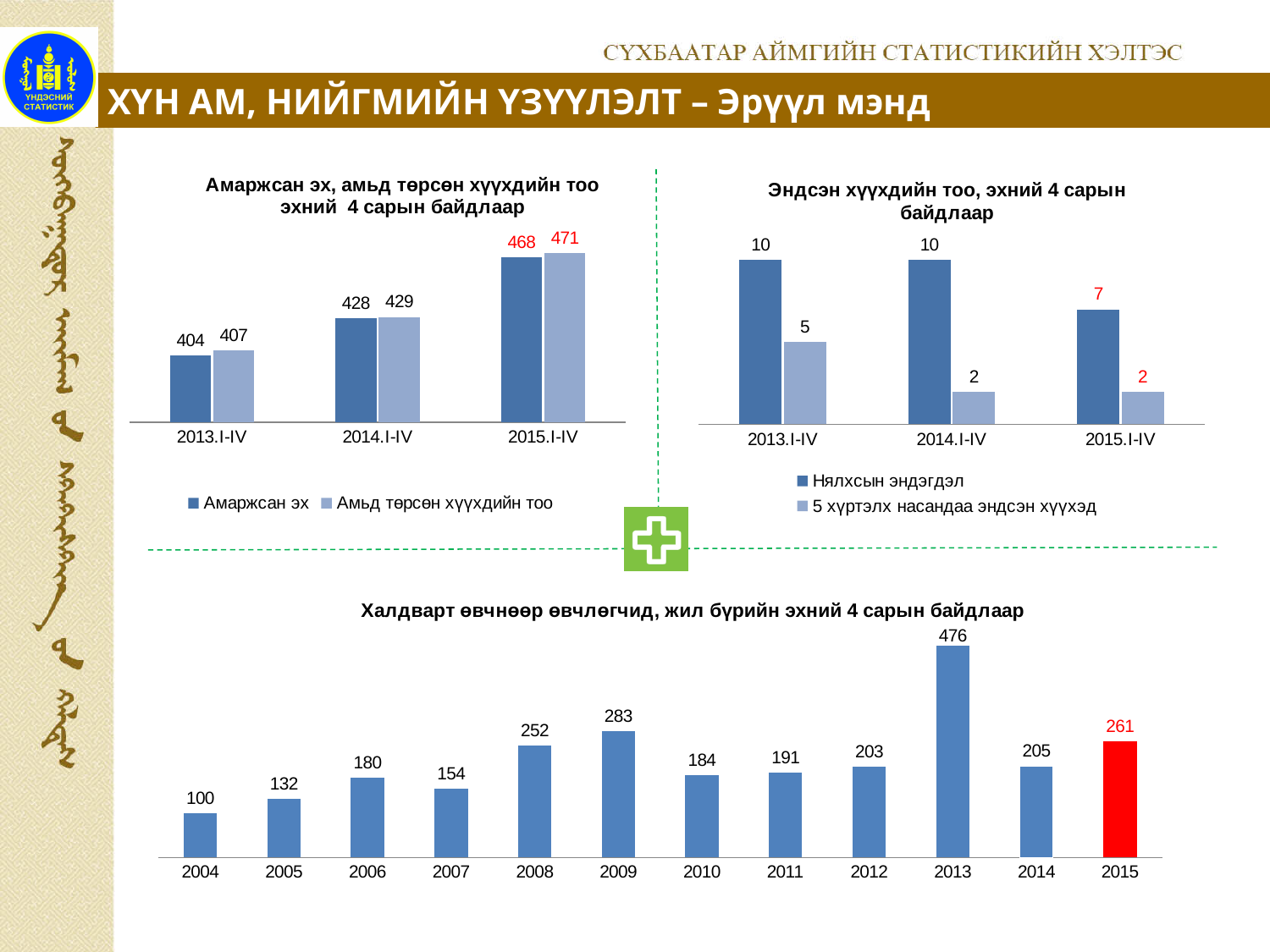
What kind of chart is the bottom chart (Халдварт өвчнөөр өвчлөгчид)? Bar chart In the top-left chart (Амаржсан эх, амьд төрсөн хүүхдийн тоо), what is the difference between Амьд төрсөн хүүхдийн тоо and Амаржсан эх in 2015.I-IV? 3 In the top-right chart (Эндсэн хүүхдийн тоо), what is the value for 5 хүртэлх насандаа эндсэн хүүхэд in 2013.I-IV? 5 In the bottom chart (Халдварт өвчнөөр өвчлөгчид), which year has the lowest value? 2004 In the top-left chart (Амаржсан эх, амьд төрсөн хүүхдийн тоо), what is the value for Амьд төрсөн хүүхдийн тоо in 2013.I-IV? 407 In the top-left chart (Амаржсан эх, амьд төрсөн хүүхдийн тоо), what is the value for Амаржсан эх in 2015.I-IV? 468 In the bottom chart (Халдварт өвчнөөр өвчлөгчид), which year has the highest value? 2013 In the top-right chart (Эндсэн хүүхдийн тоо), what is the difference between Нялхсын эндэгдэл and 5 хүртэлх насандаа эндсэн хүүхэд in 2014.I-IV? 8 In the bottom chart (Халдварт өвчнөөр өвчлөгчид), how many years are shown on the x axis? 12 In the bottom chart (Халдварт өвчнөөр өвчлөгчид), what is the value for 2015? 261 In the top-left chart (Амаржсан эх, амьд төрсөн хүүхдийн тоо), how many series does the legend list? 2 In the top-right chart (Эндсэн хүүхдийн тоо), what is the value for Нялхсын эндэгдэл in 2015.I-IV? 7